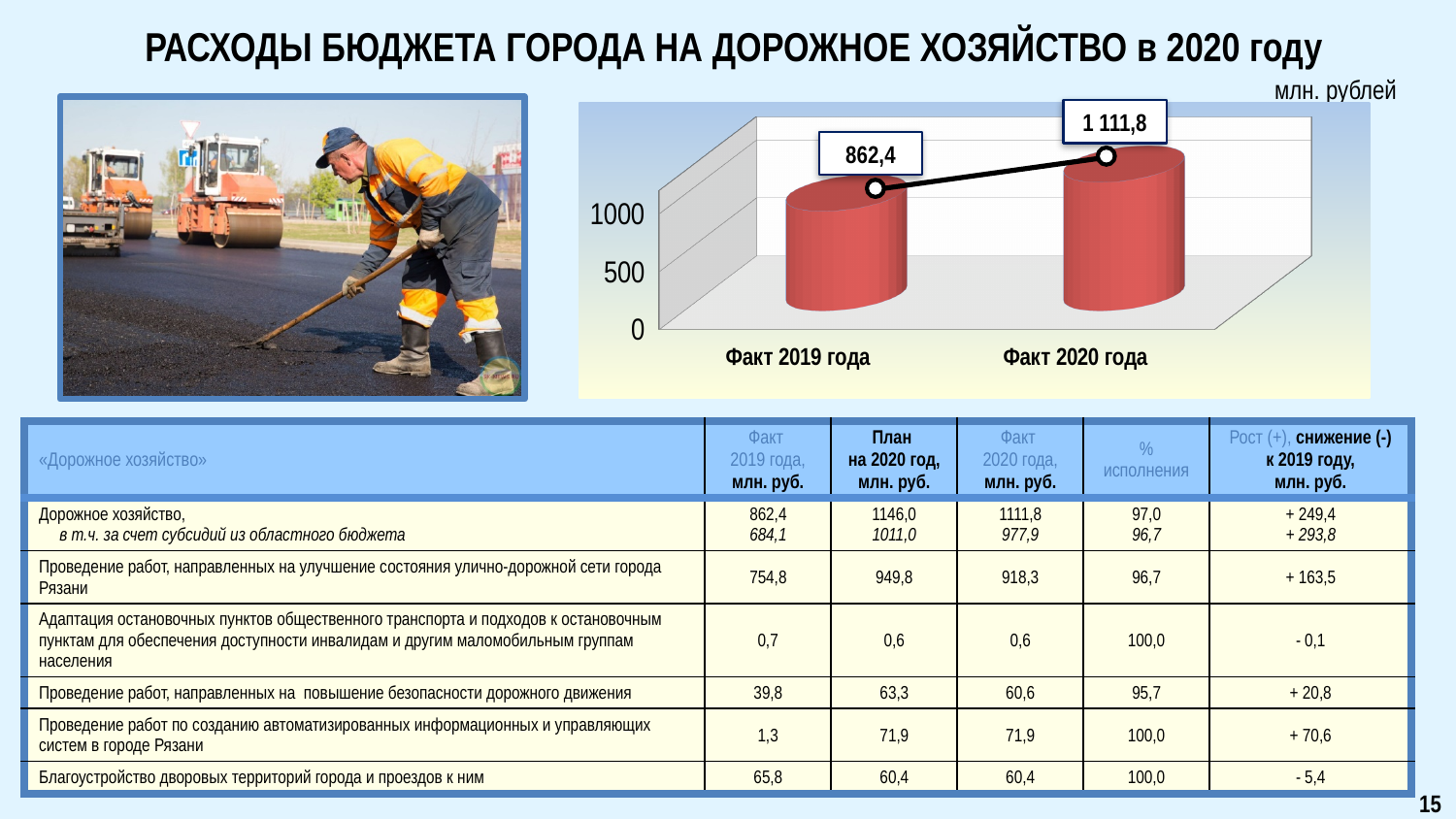
Is the value for Факт 2019 года on the chart greater or less than 1000? less What is the value for Факт 2019 года on the chart? 862,4 Which is larger on the chart: the value for Факт 2019 года or Факт 2020 года? Факт 2020 года What kind of chart is shown on the slide? bar chart What is the difference between the values for Факт 2020 года and Факт 2019 года on the chart? 249,4 What unit of measurement is indicated above the chart? млн. рублей Which category on the chart has the highest value? Факт 2020 года Is the value for Факт 2020 года on the chart greater or less than 1000? greater What is the value for Факт 2020 года on the chart? 1 111,8 Which category on the chart has the lowest value? Факт 2019 года Do the values on the chart rise or fall from Факт 2019 года to Факт 2020 года? rise How many categories are shown on the chart? 2